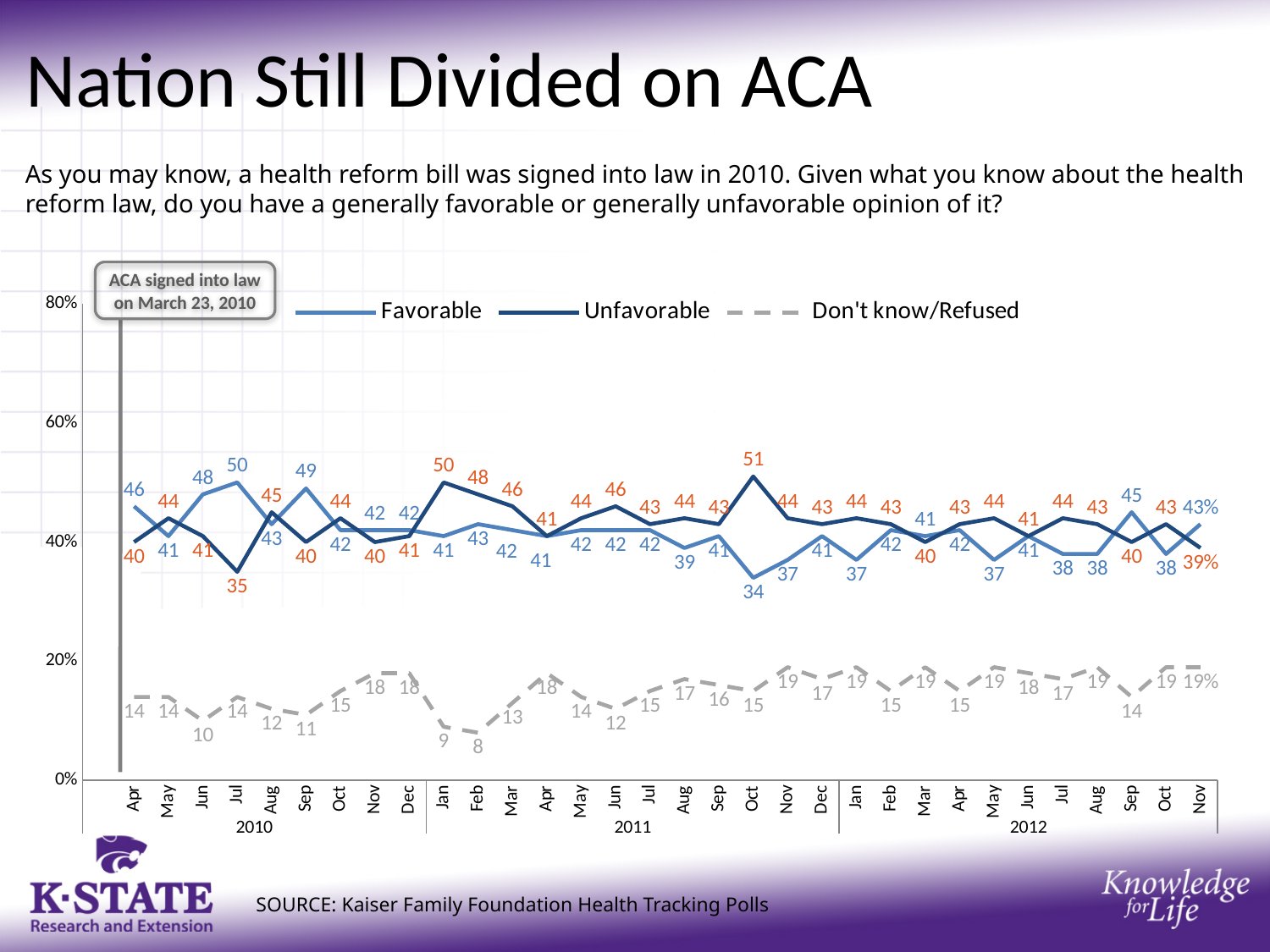
What type of chart is shown on the slide? Line chart What was the Don't know/Refused value in February 2011? 8 What was the Favorable value in November 2012? 43% What was the Unfavorable value in July 2010? 35 How many series does the legend list? 3 In which month did the Unfavorable series reach its highest value? Oct 2011 In July 2010, which was larger, Favorable or Unfavorable? Favorable According to the annotation on the chart, on what date was the ACA signed into law? March 23, 2010 What is the difference between the Unfavorable and Favorable values in October 2011? 17 In which month did the Favorable series reach its lowest value? Oct 2011 What was the Unfavorable value in October 2011? 51 What was the Favorable value in September 2012? 45